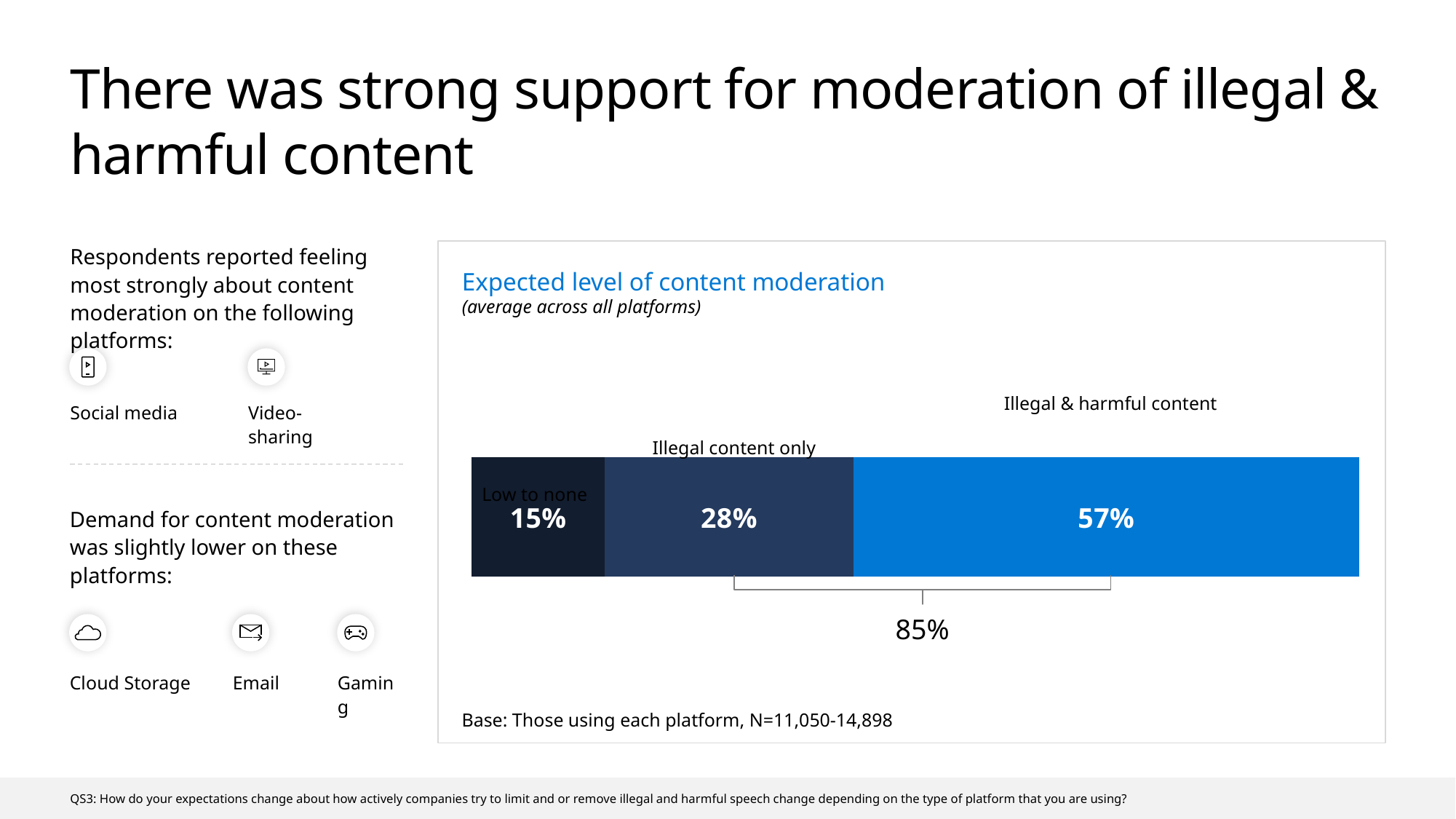
What is the difference between the 'Illegal & harmful content' and 'Illegal content only' values? 29 percentage points What is the value for 'Low to none' in the Expected level of content moderation chart? 15% What is the value for 'Illegal & harmful content' in the Expected level of content moderation chart? 57% What is the difference between the 'Illegal content only' and 'Low to none' values? 13 percentage points Which segment of the Expected level of content moderation bar is the smallest? Low to none What is the value for 'Illegal content only' in the Expected level of content moderation chart? 28% How many segments make up the Expected level of content moderation bar? 3 Which is larger, the 'Illegal content only' value or the 'Low to none' value? Illegal content only Which segment of the Expected level of content moderation bar is the largest? Illegal & harmful content What is the combined value of 'Illegal content only' and 'Illegal & harmful content' shown under the bar? 85% What kind of chart is shown on the slide? Stacked bar chart What is the title of the chart on the slide? Expected level of content moderation